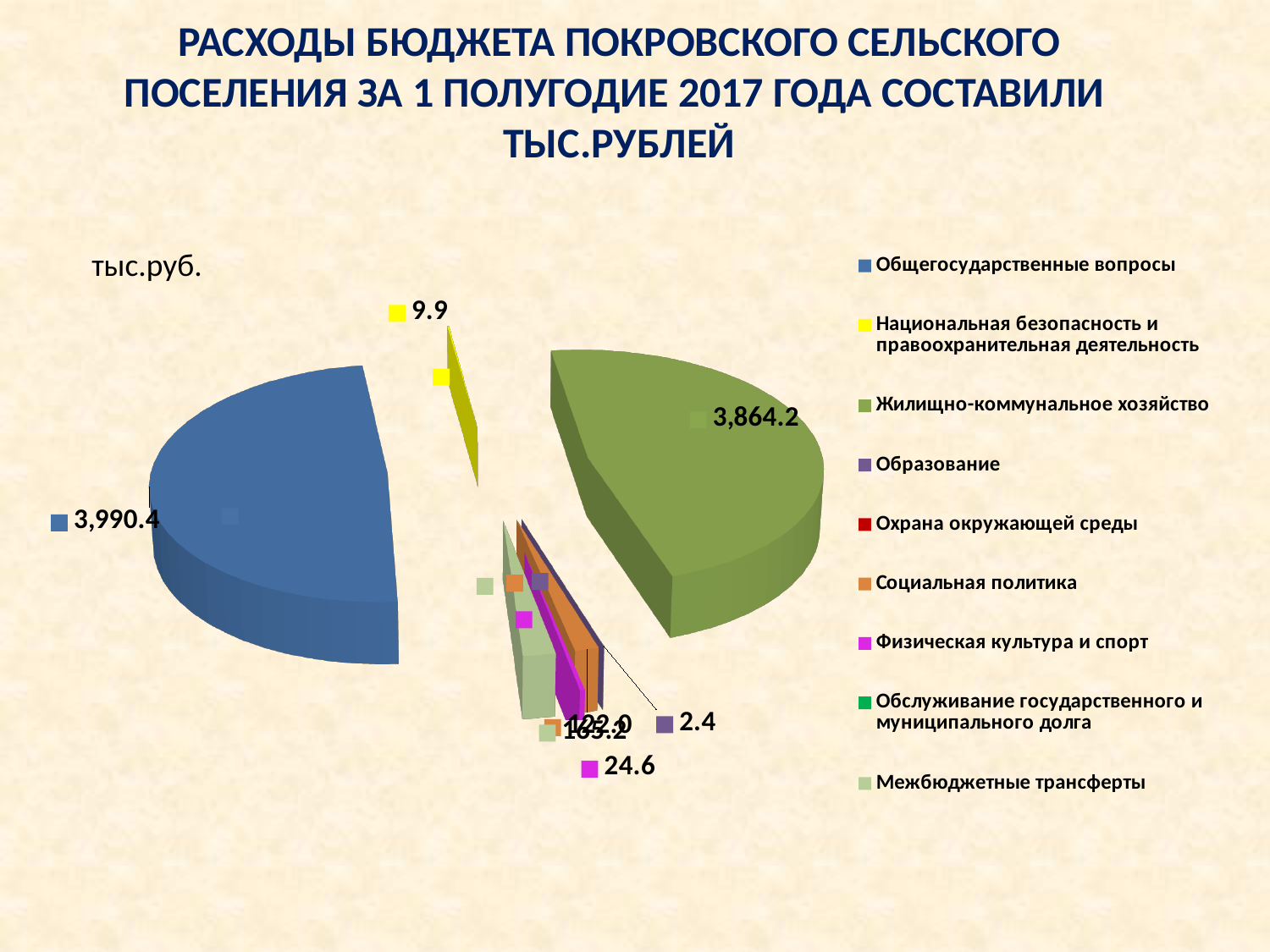
What is the value for Национальная безопасность и правоохранительная деятельность? 9.9 What is the value for Жилищно-коммунальное хозяйство? 3,864.2 What unit label is shown above the chart? тыс.руб. What is the value for Физическая культура и спорт? 24.6 What is the value for Общегосударственные вопросы? 3,990.4 What is the difference between the values for Общегосударственные вопросы and Жилищно-коммунальное хозяйство? 126.2 Which category has the largest value in the pie chart? Общегосударственные вопросы How many categories does the legend list? 9 What is the value for Межбюджетные трансферты? 165.2 Which is larger, the value for Физическая культура и спорт or the value for Образование? Физическая культура и спорт What is the value for Образование? 2.4 What kind of chart is shown on the slide? pie chart